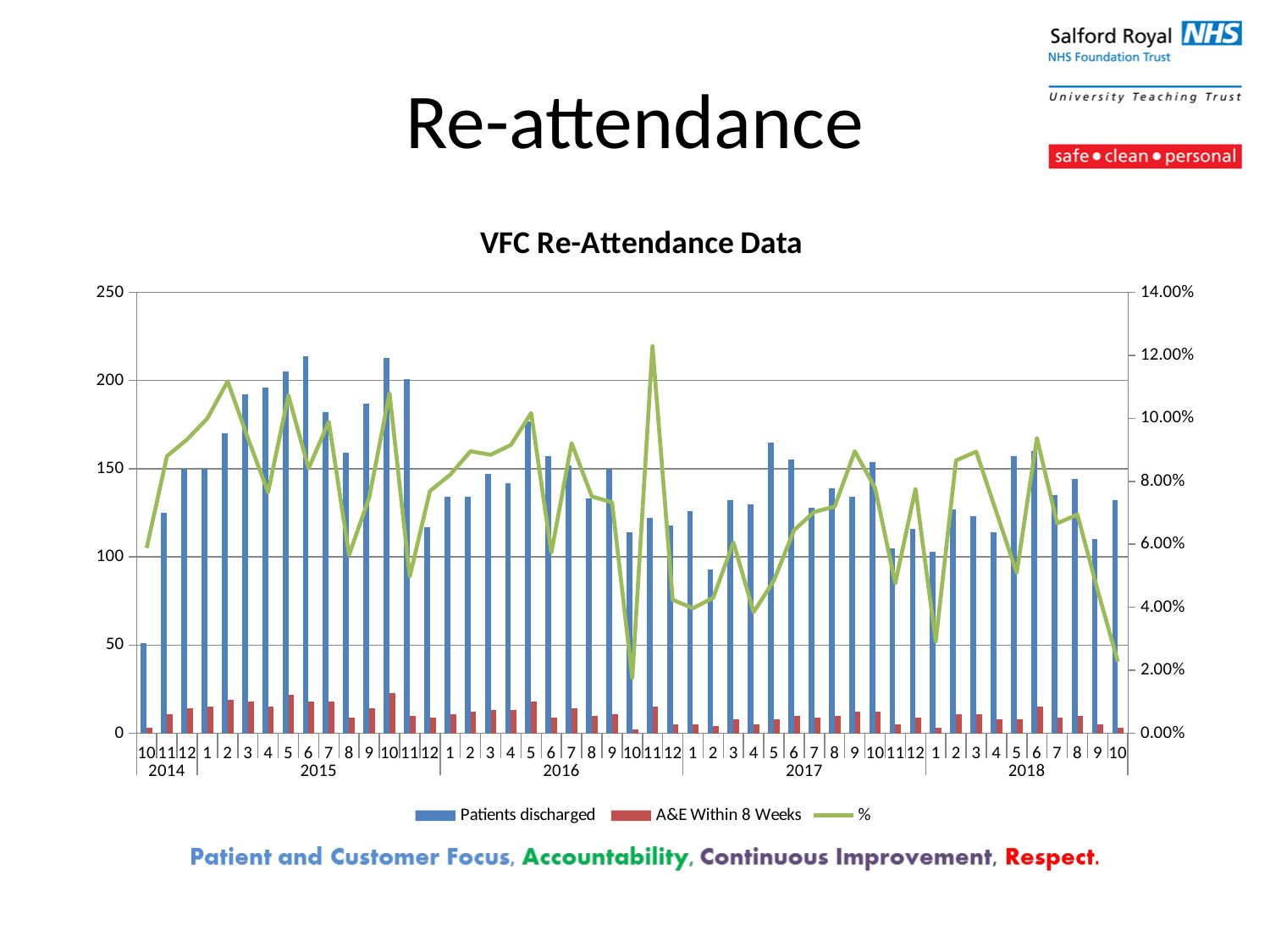
Does the % line rise or fall from month 6 of 2018 to month 10 of 2018? Fall How many series does the chart legend list? 3 Is the value of Patients discharged for month 6 of 2015 greater or less than 200? greater Is the value of Patients discharged for month 2 of 2017 greater or less than 100? less What are the three series named in the legend? Patients discharged, A&E Within 8 Weeks, % How many monthly categories are plotted along the x axis? 49 Is the % value for month 10 of 2016 greater or less than 4.00%? less What is the title of the chart? VFC Re-Attendance Data In which month is the % line at its highest? 11 2016 Which is larger, Patients discharged in month 2 of 2017 or in month 5 of 2017? Month 5 of 2017 What kind of chart is shown? Combined bar and line chart